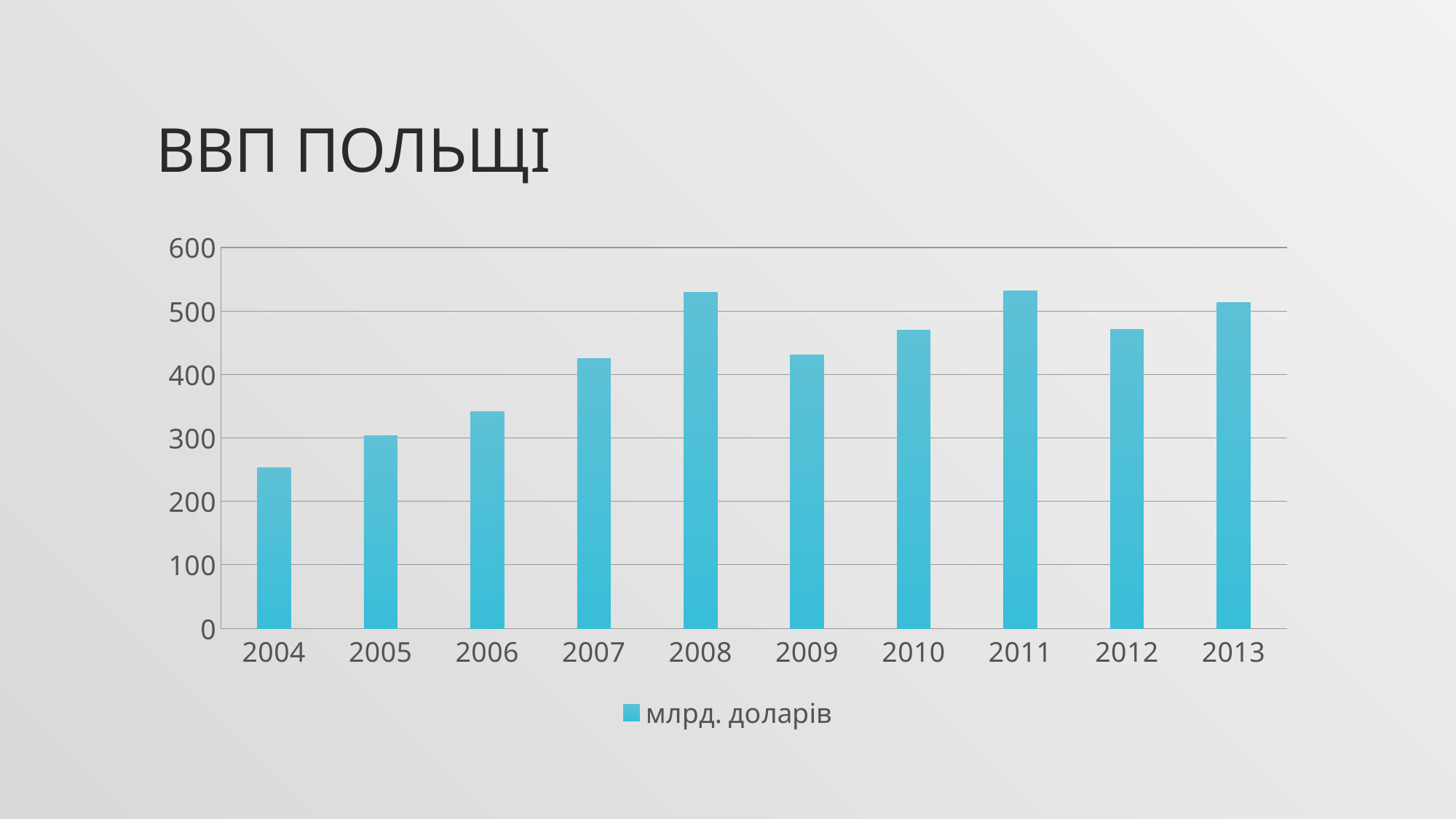
What is the title of the chart? ВВП ПОЛЬЩІ How many series does the legend list? 1 Do the values rise or fall from 2004 to 2008? rise Is the value for 2008 greater or less than 500? greater Is the value for 2009 greater or less than 500? less How many years are shown on the x axis? 10 Is the value for 2004 greater or less than 300? less Which is larger, the value for 2008 or the value for 2009? 2008 What series does the legend list? млрд. доларів What kind of chart is shown on the slide? bar chart Which year has the lowest value? 2004